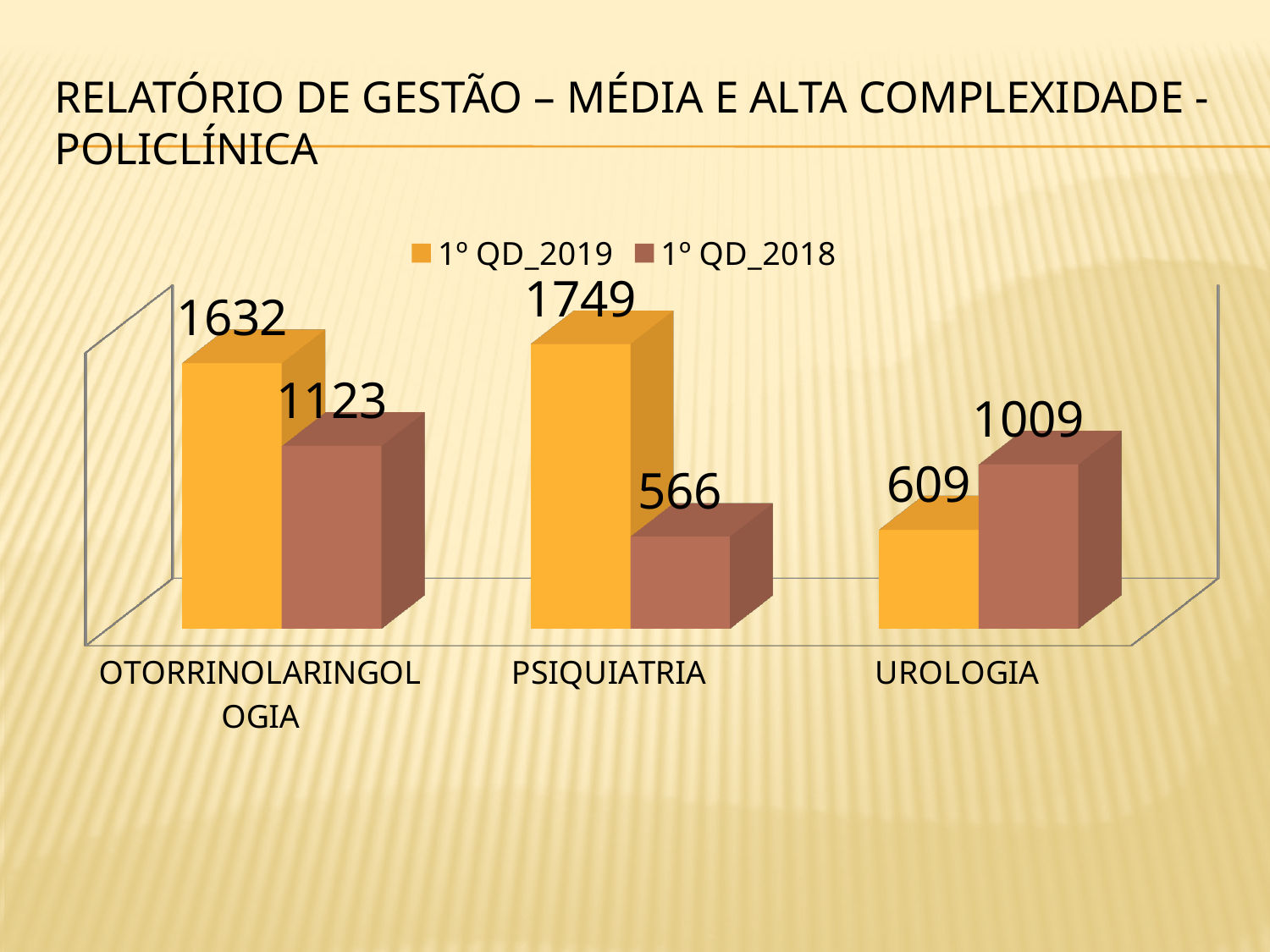
Which is larger for OTORRINOLARINGOLOGIA: the 1º QD_2019 value or the 1º QD_2018 value? 1º QD_2019 Which category has the lowest value in the 1º QD_2018 series? PSIQUIATRIA What is the value for PSIQUIATRIA in the 1º QD_2018 series? 566 How many series does the legend list? 2 What kind of chart is shown on the slide? Bar chart What is the value for OTORRINOLARINGOLOGIA in the 1º QD_2019 series? 1632 What is the difference between the 1º QD_2019 and 1º QD_2018 values for PSIQUIATRIA? 1183 What is the difference between the 1º QD_2018 and 1º QD_2019 values for UROLOGIA? 400 How many categories are shown on the x axis? 3 What is the value for UROLOGIA in the 1º QD_2018 series? 1009 Which category has the highest value in the 1º QD_2019 series? PSIQUIATRIA What is the value for PSIQUIATRIA in the 1º QD_2019 series? 1749